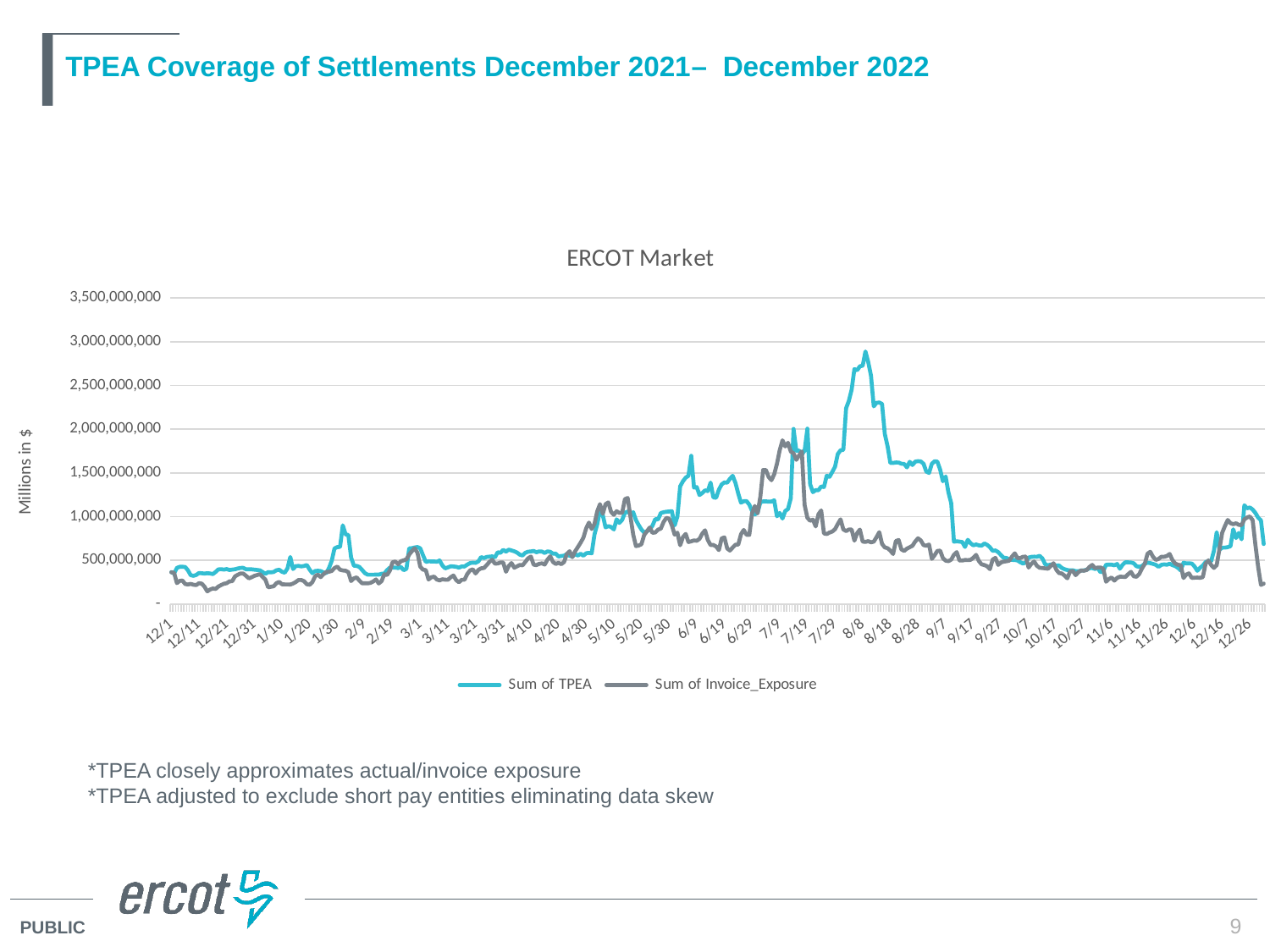
What label is shown on the vertical axis of the chart? Millions in $ How many series does the legend list? 2 Is the peak value of the Sum of TPEA series greater or less than 3,000,000,000? less What is the highest value shown on the vertical axis? 3,500,000,000 Is the peak value of the Sum of Invoice_Exposure series greater or less than 2,500,000,000? less What kind of chart is shown on the slide? Line chart Which series reaches the higher peak value, Sum of TPEA or Sum of Invoice_Exposure? Sum of TPEA Around which x-axis date does the Sum of TPEA series reach its highest value? 8/8 What is the title of the chart? ERCOT Market Is the value of Sum of TPEA at 12/1 greater or less than 1,000,000,000? less Does the Sum of TPEA series rise or fall between 8/8 and 9/17? fall